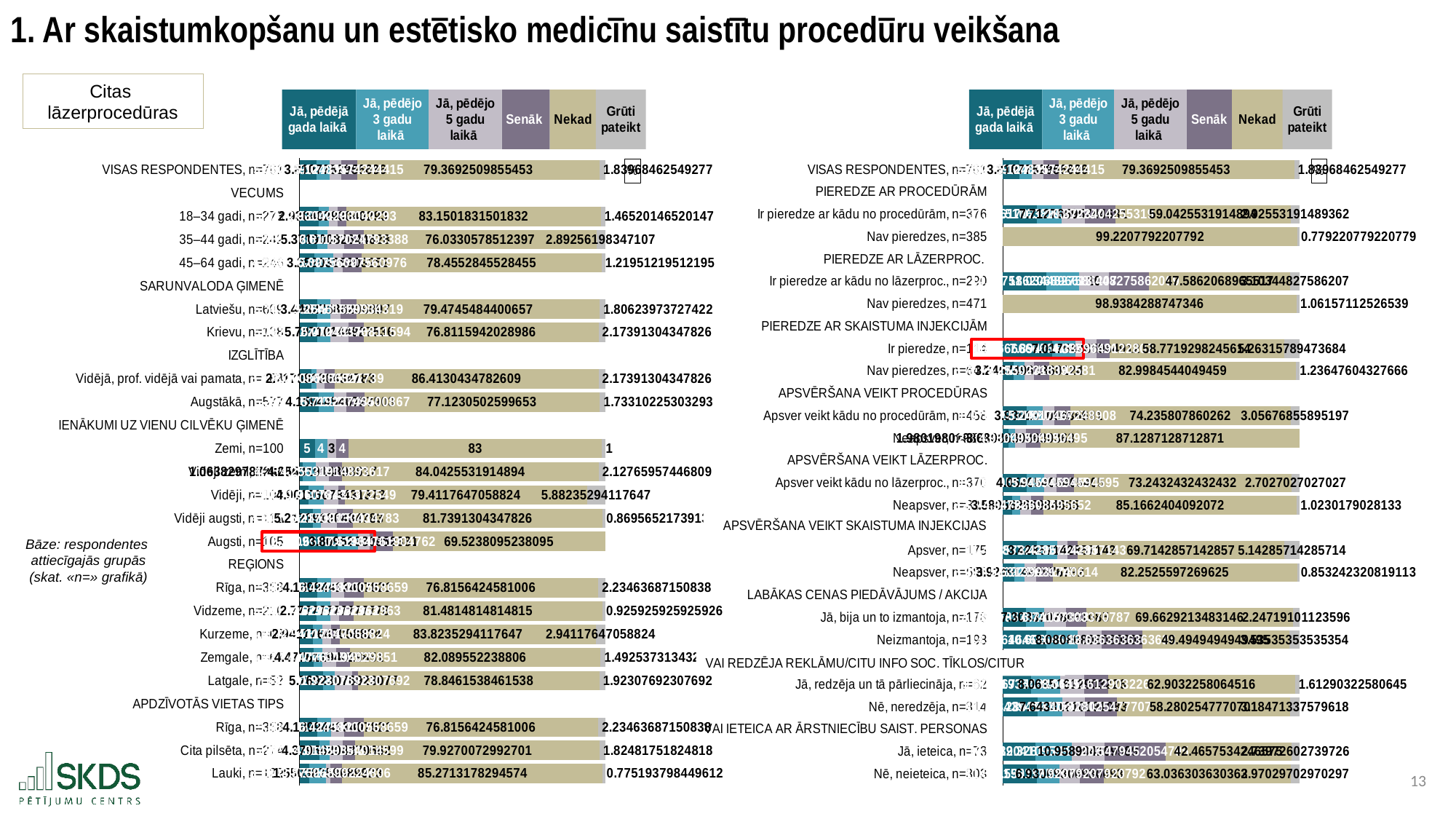
On the right chart, what is the 'Nekad' value for 'Jā, ieteica, n=73'? 42.4657534246575 On the left chart, which region has the highest 'Nekad' value: Rīga, Vidzeme, Kurzeme, Zemgale or Latgale? Kurzeme On the left chart, what is the 'Nekad' value for 'Zemi, n=100'? 83 On the left chart, is the 'Nekad' value larger for 'Lauki' or for 'Rīga'? Lauki On the left chart, what is the 'Grūti pateikt' value for 'Zemi, n=100'? 1 Which series is shown in the darkest blue colour in the legend? Jā, pēdējā gada laikā On the left chart, what is the 'Nekad' value for 'VISAS RESPONDENTES'? 79.3692509855453 On the right chart, is the 'Nekad' value larger for 'Nav pieredzes, n=385' or for 'Nav pieredzes, n=471'? Nav pieredzes, n=385 On the right chart, what is the 'Nekad' value for 'Nav pieredzes, n=385'? 99.2207792207792 What kind of chart is shown on the left side of the slide? Stacked horizontal bar chart How many series does the legend of the left chart list? 6 On the left chart, what is the difference between the 'Nekad' values for '18–34 gadi' and '35–44 gadi'? 7.1171252989435